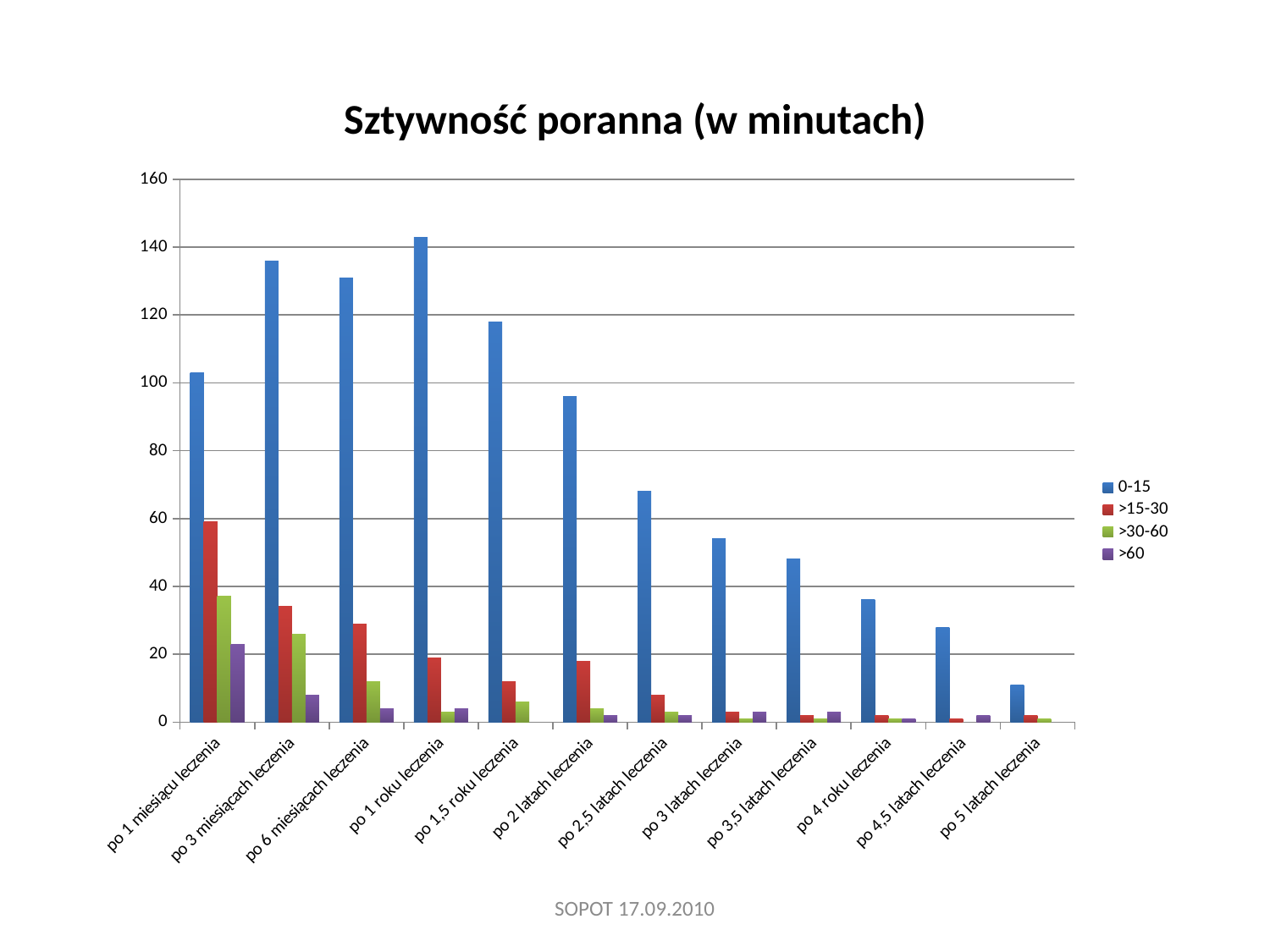
What kind of chart is shown on the slide? bar chart Is the 0-15 value for po 3 miesiącach leczenia greater or less than 120? greater From po 1 roku leczenia to po 5 latach leczenia, do the 0-15 values rise or fall? fall Is the 0-15 value for po 2 latach leczenia greater or less than 100? less For the 0-15 series, which category has the lowest value? po 5 latach leczenia How many categories are shown along the x axis? 12 What is the title of the chart? Sztywność poranna (w minutach) How many series does the legend list? 4 Is the >15-30 value for po 1 miesiącu leczenia greater or less than 40? greater For the 0-15 series, which category has the highest value? po 1 roku leczenia For the >15-30 series, which category has the highest value? po 1 miesiącu leczenia Which is larger for the 0-15 series: po 1 roku leczenia or po 1,5 roku leczenia? po 1 roku leczenia